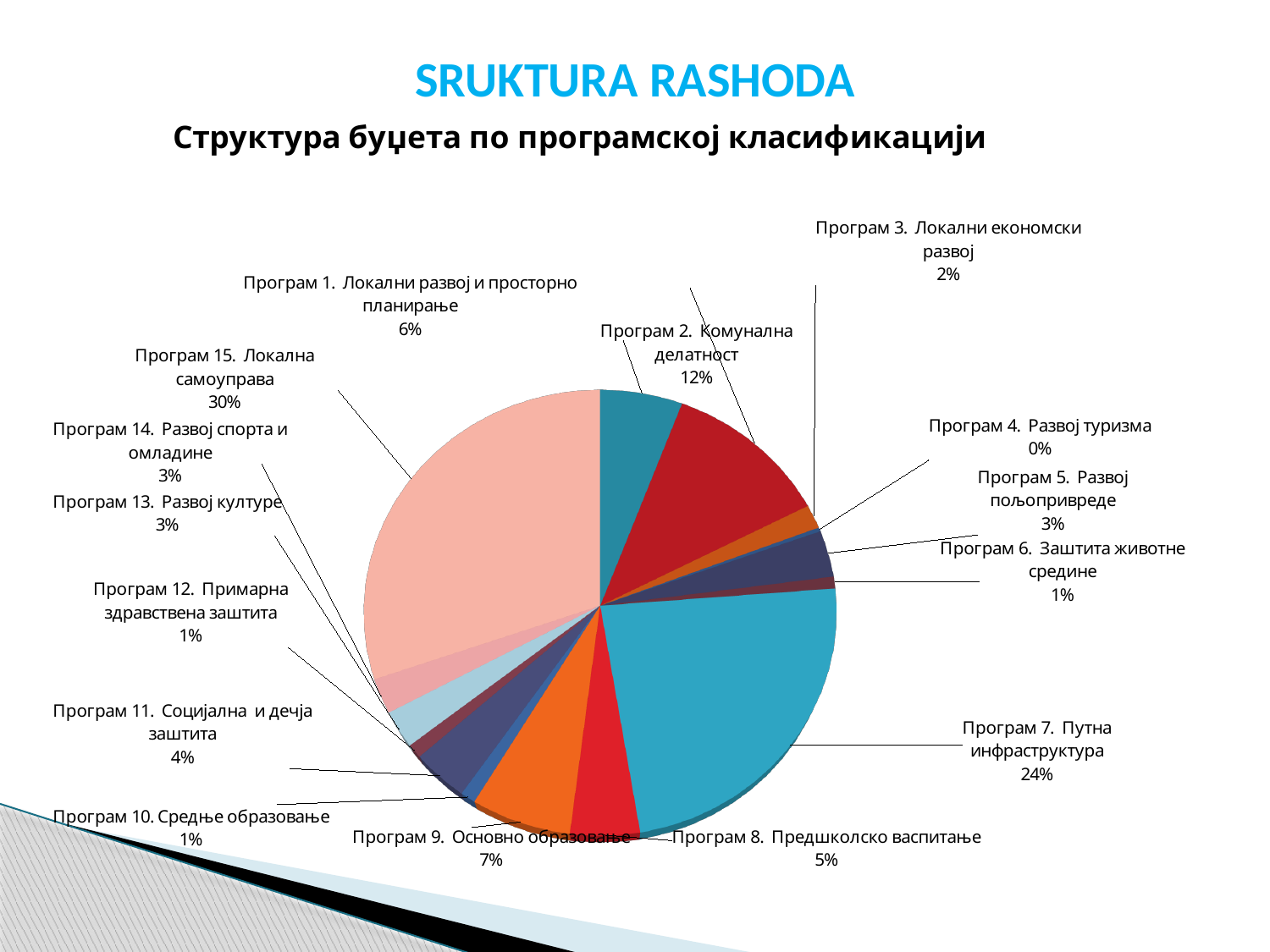
What is the difference in percentage points between Програм 15. Локална самоуправа and Програм 7. Путна инфраструктура? 6 percentage points Which program has the largest share of the budget? Програм 15. Локална самоуправа What percentage is shown for Програм 2. Комунална делатност? 12% What is the title of the chart? Структура буџета по програмској класификацији What kind of chart is shown on the slide? Pie chart What percentage is shown for Програм 9. Основно образовање? 7% Which has a larger share: Програм 2. Комунална делатност or Програм 9. Основно образовање? Програм 2. Комунална делатност Which program has the smallest share of the budget? Програм 4. Развој туризма What share of the budget does Програм 15. Локална самоуправа have? 30% What share of the budget does Програм 7. Путна инфраструктура have? 24% How many programs (slices) are shown in the pie chart? 15 What percentage is shown for Програм 11. Социјална и дечја заштита? 4%